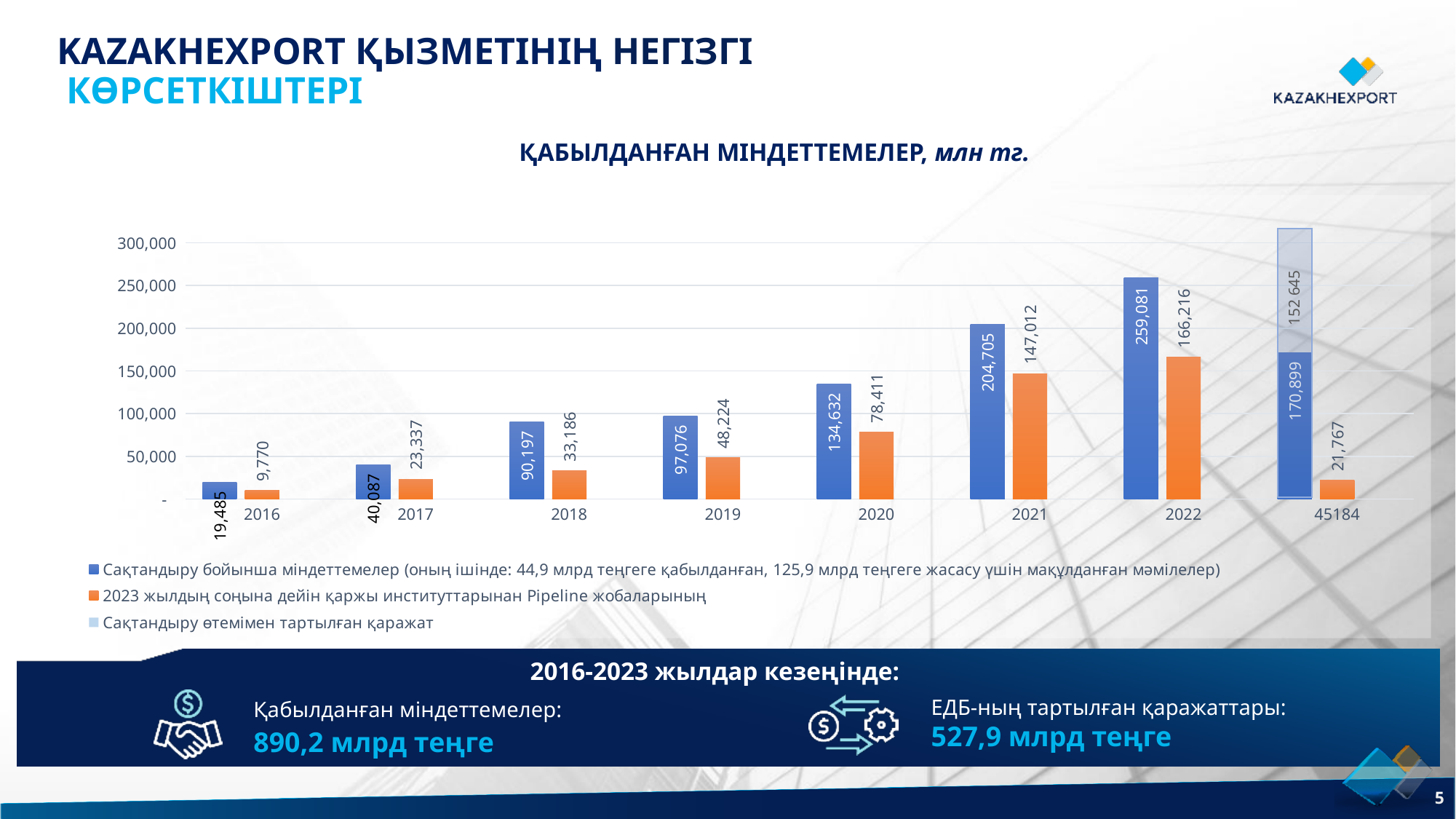
How many categories are shown on the x axis? 8 What is the difference between the blue and orange values for 2022? 92,865 How many series does the legend list? 3 Does the blue series (Сақтандыру бойынша міндеттемелер) rise or fall from 2016 to 2022? rise In which year is the blue series (Сақтандыру бойынша міндеттемелер) highest? 2022 Which is larger for 2021: the blue series value or the orange series value? the blue series (204,705) What is the title of the chart? ҚАБЫЛДАНҒАН МІНДЕТТЕМЕЛЕР, млн тг. What is the value of the orange series (Pipeline жобаларының) for 2019? 48,224 What type of chart is shown on the slide? bar chart What is the value of the blue series (Сақтандыру бойынша міндеттемелер) for 2020? 134,632 What is the value of the light blue series (Сақтандыру өтемімен тартылған қаражат) for the category labelled 45184? 152 645 In which year is the orange series (Pipeline жобаларының) lowest? 2016